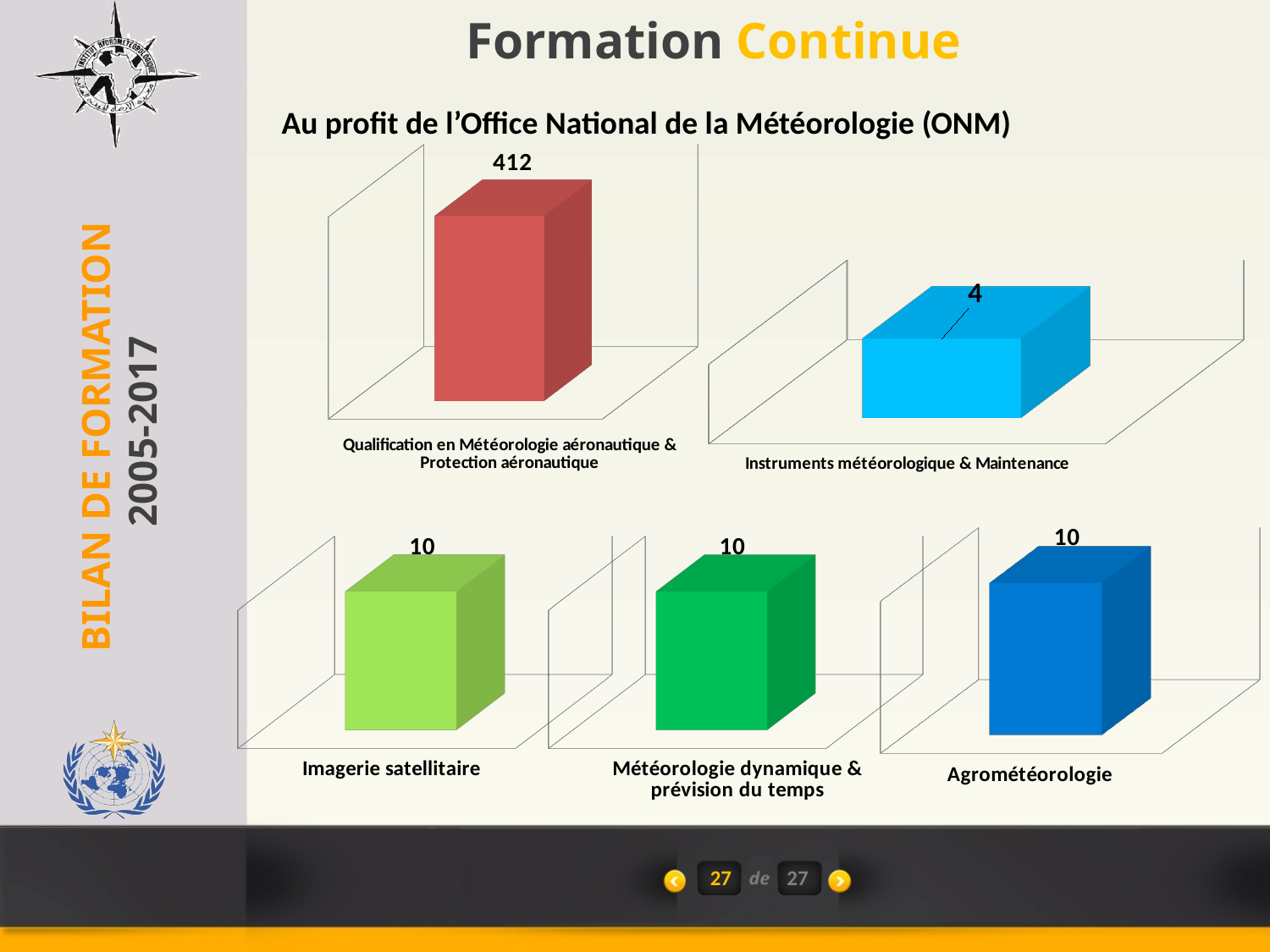
On the chart labelled "Qualification en Météorologie aéronautique & Protection aéronautique", what value is shown on the bar? 412 How many separate charts are shown on the slide? 5 On the chart labelled "Instruments météorologique & Maintenance", what value is shown on the bar? 4 What is the difference between the value on the "Qualification en Météorologie aéronautique & Protection aéronautique" chart and the value on the "Instruments météorologique & Maintenance" chart? 408 Across all the charts on the slide, which category has the highest value? Qualification en Météorologie aéronautique & Protection aéronautique What kind of chart is the "Imagerie satellitaire" chart? Bar chart On the chart labelled "Imagerie satellitaire", what value is shown on the bar? 10 What is the difference between the value on the "Imagerie satellitaire" chart and the value on the "Instruments météorologique & Maintenance" chart? 6 Which is larger: the value on the "Agrométéorologie" chart or the value on the "Instruments météorologique & Maintenance" chart? Agrométéorologie On the chart labelled "Météorologie dynamique & prévision du temps", what value is shown on the bar? 10 On the chart labelled "Agrométéorologie", what value is shown on the bar? 10 Across all the charts on the slide, which category has the lowest value? Instruments météorologique & Maintenance